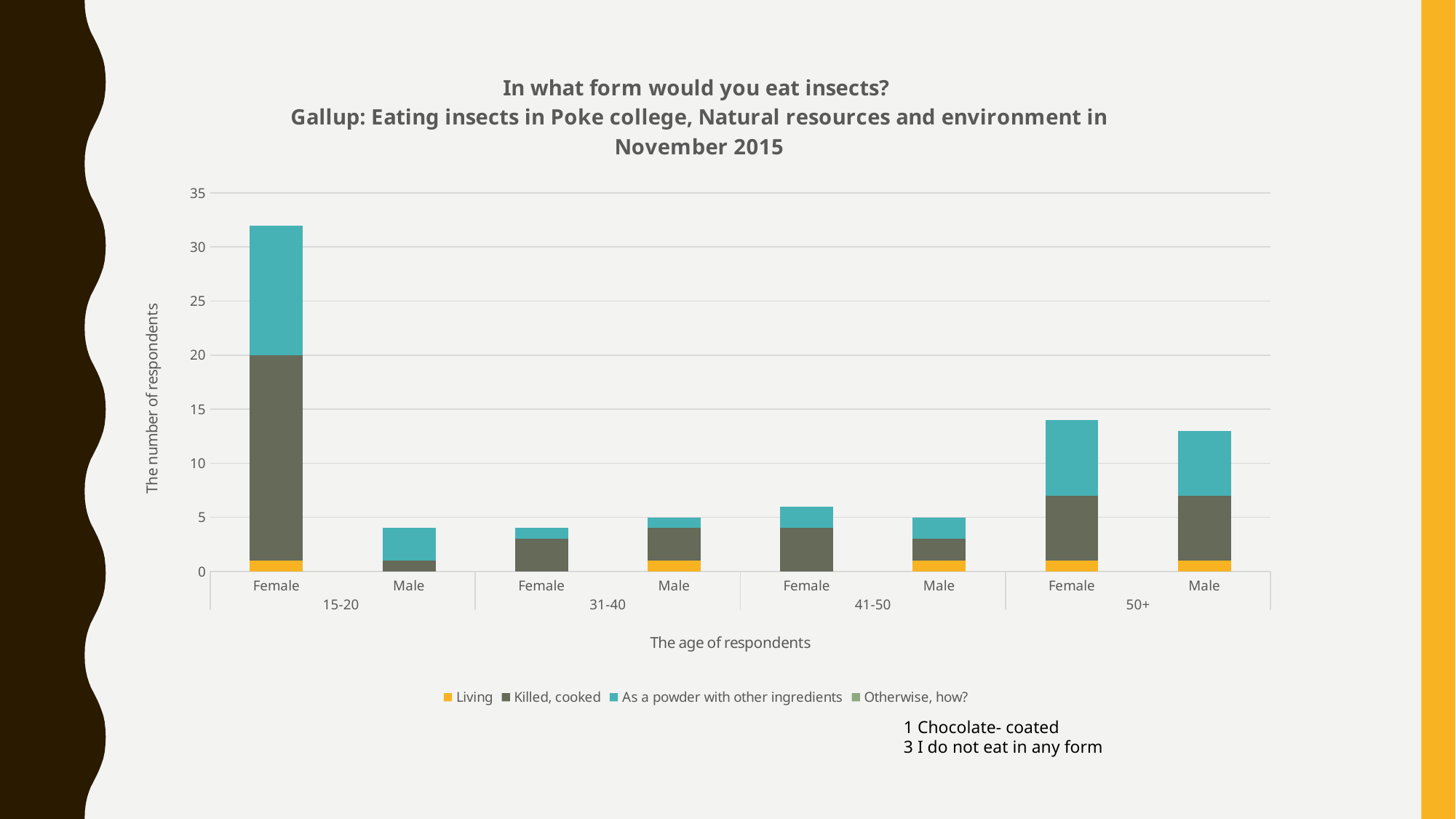
Is the total for Female in the 50+ age group greater or less than 15? less Which bar has the highest total number of respondents? Female, 15-20 What is the label of the x axis? The age of respondents Which bar is taller: Female 50+ or Female 41-50? Female 50+ How many bars are plotted in the chart? 8 How many age groups are shown on the x axis? 4 Is the total for Male in the 50+ age group greater or less than 10? greater What is the label of the y axis? The number of respondents How many series does the legend list? 4 What kind of chart is shown on the slide? Stacked bar chart Which bar is taller: Female 15-20 or Male 15-20? Female 15-20 Is the total for Female in the 15-20 age group greater or less than 30? greater